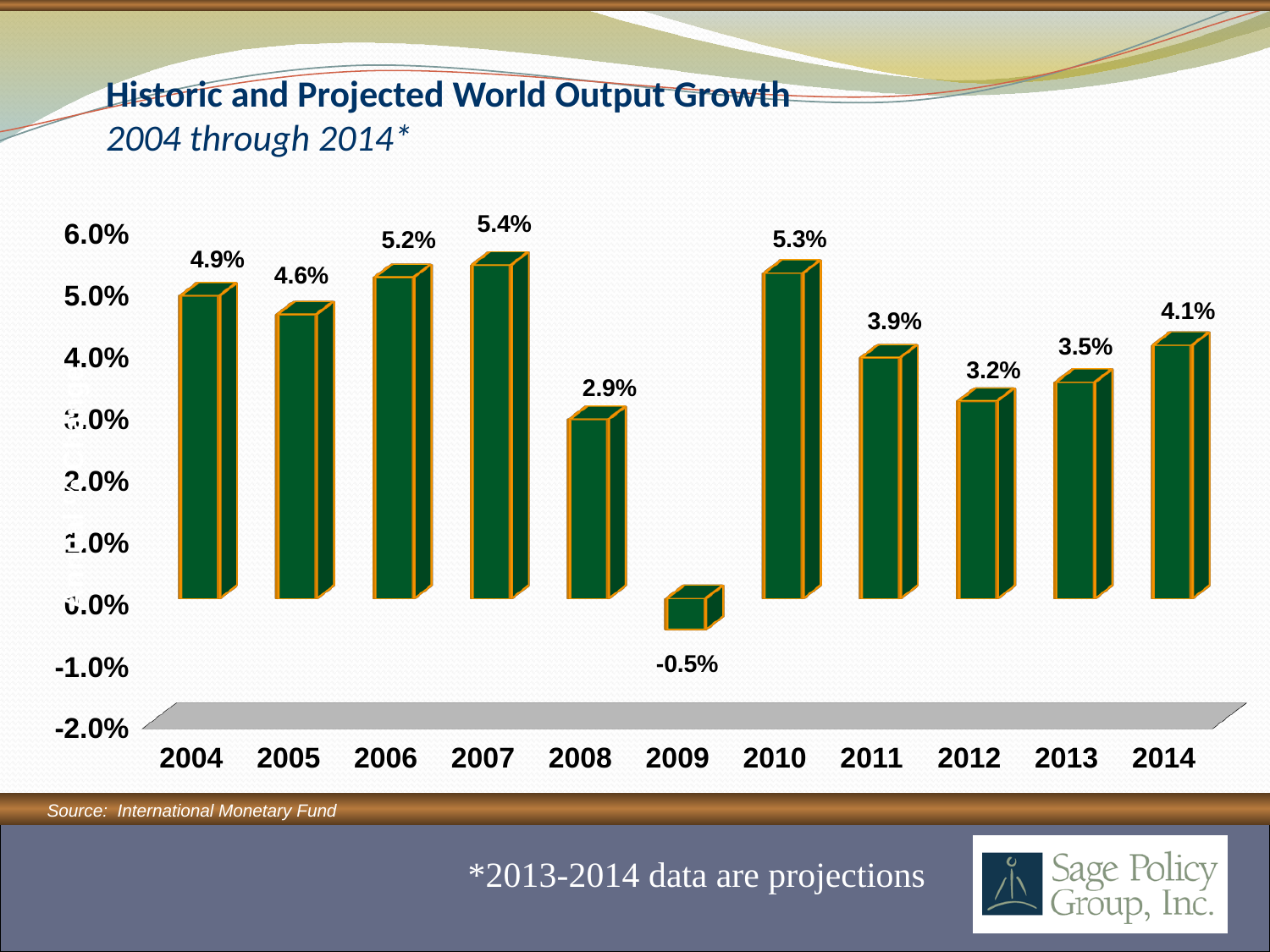
Do the values rise or fall from 2010 to 2012? Fall Which year has the lowest world output growth? 2009 Which year has the larger value, 2008 or 2013? 2013 What is the title of the chart? Historic and Projected World Output Growth Which year has the highest world output growth? 2007 What is the source cited for the chart data? International Monetary Fund What is the world output growth value for 2009? -0.5% What kind of chart is shown on the slide? Bar chart What is the world output growth value for 2012? 3.2% What is the world output growth value for 2007? 5.4% How many years are shown on the x axis? 11 What is the difference between the 2010 value and the 2011 value? 1.4%